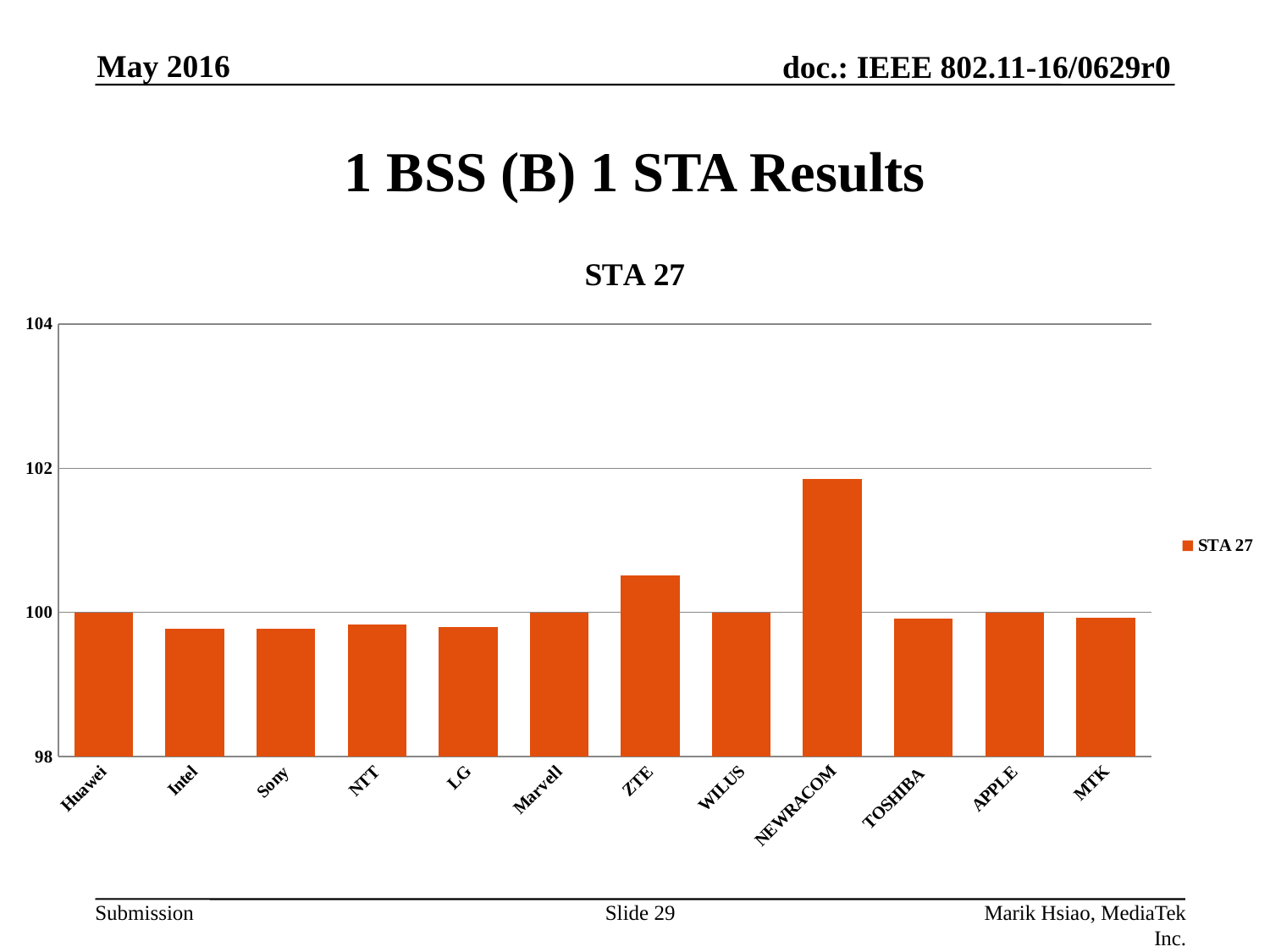
Which category has the highest value in the chart? NEWRACOM Is the value for NEWRACOM greater or less than 100? greater What is the name of the series shown in the legend? STA 27 What type of chart is shown on the slide? bar chart Is the value for ZTE greater or less than 100? greater What is the title of the chart? STA 27 Which is larger, the value for NEWRACOM or the value for ZTE? NEWRACOM How many series does the legend list? 1 How many categories are shown on the x axis of the chart? 12 Is the value for Intel greater or less than 100? less Which is larger, the value for ZTE or the value for Sony? ZTE